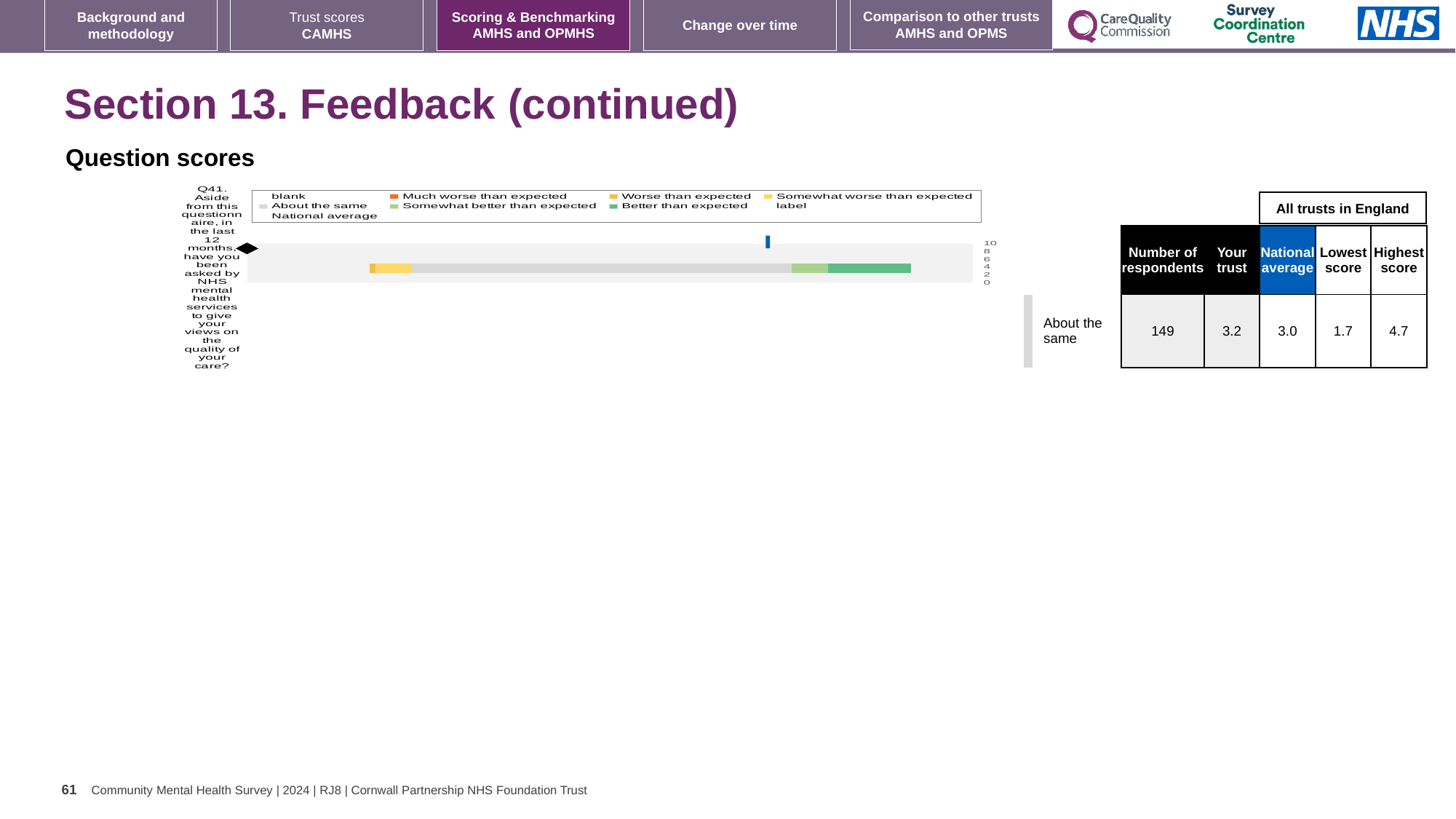
Which is larger for Q41, the 'Your trust' score or the national average? Your trust What is the 'Your trust' score for Q41 in the table beside the chart? 3.2 What colour does the legend use for 'Better than expected'? green Which question number is plotted in the chart? Q41 How many entries does the chart legend list? 9 What is the highest score among all trusts in England for Q41? 4.7 How many survey questions are plotted in the chart? 1 What benchmark category is shown for Q41 next to the chart? About the same What kind of chart is shown on the slide? bar chart What is the national average score for Q41 in the table beside the chart? 3.0 What is the difference between the highest score and the lowest score for Q41 in the table? 3.0 How many respondents answered Q41 according to the table beside the chart? 149